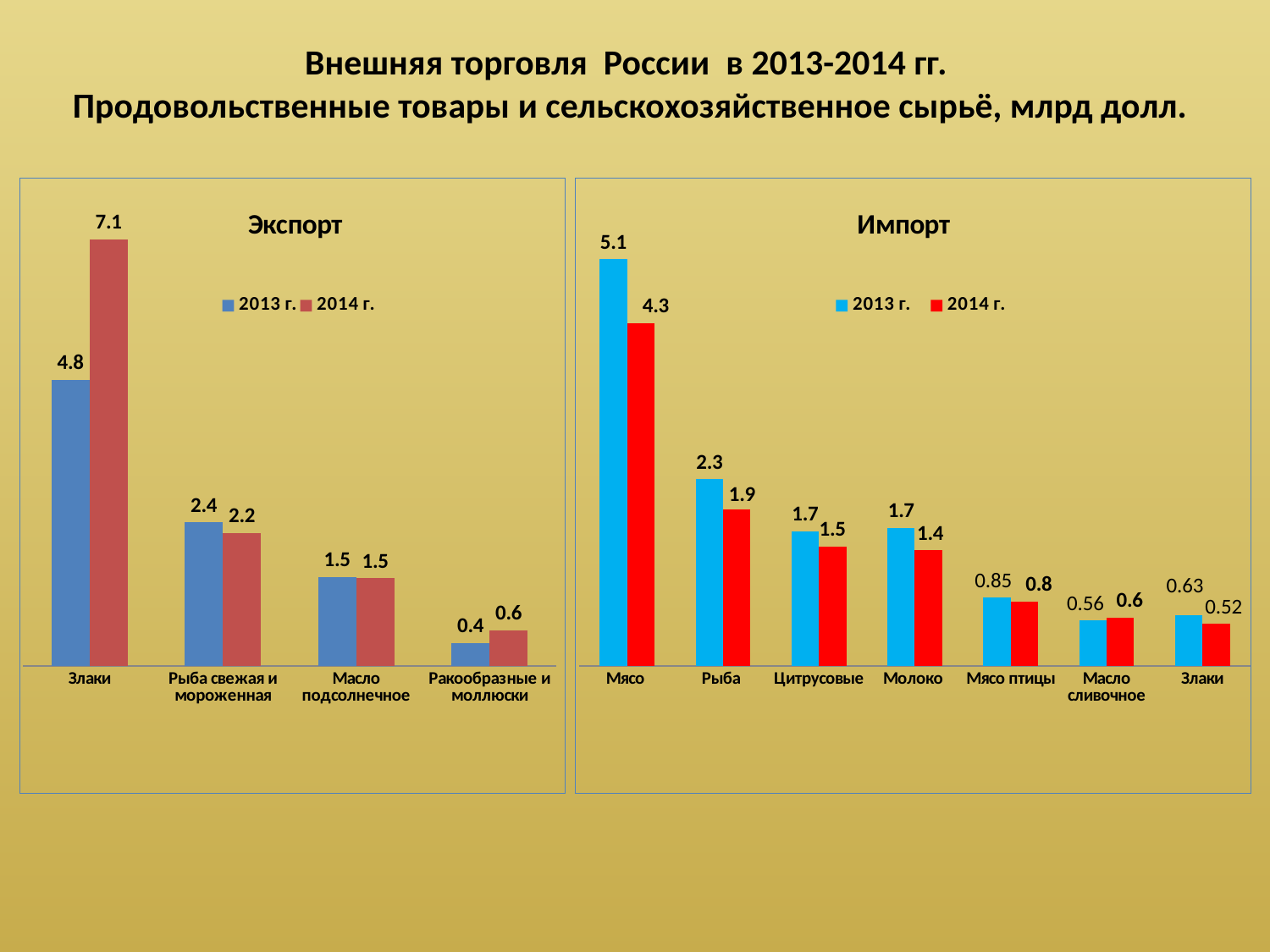
How many categories are shown in the Импорт chart? 7 How many series does the legend of the Экспорт chart list? 2 In the Импорт chart, what is the value for Масло сливочное in 2014 г.? 0.6 In the Экспорт chart, what is the value for Рыба свежая и мороженная in 2013 г.? 2.4 What type of chart is the Экспорт chart? Bar chart In the Импорт chart, what is the value for Мясо in 2013 г.? 5.1 In the Экспорт chart, which category has the lowest value in 2013 г.? Ракообразные и моллюски In the Импорт chart, which category has the highest value in 2014 г.? Мясо In the Экспорт chart, what is the value for Злаки in 2014 г.? 7.1 In the Экспорт chart, what is the difference between the 2014 г. and 2013 г. values for Злаки? 2.3 In the Импорт chart, which is larger for Рыба: the 2013 г. value or the 2014 г. value? 2013 г. In the Импорт chart, what is the difference between the 2013 г. and 2014 г. values for Мясо? 0.8